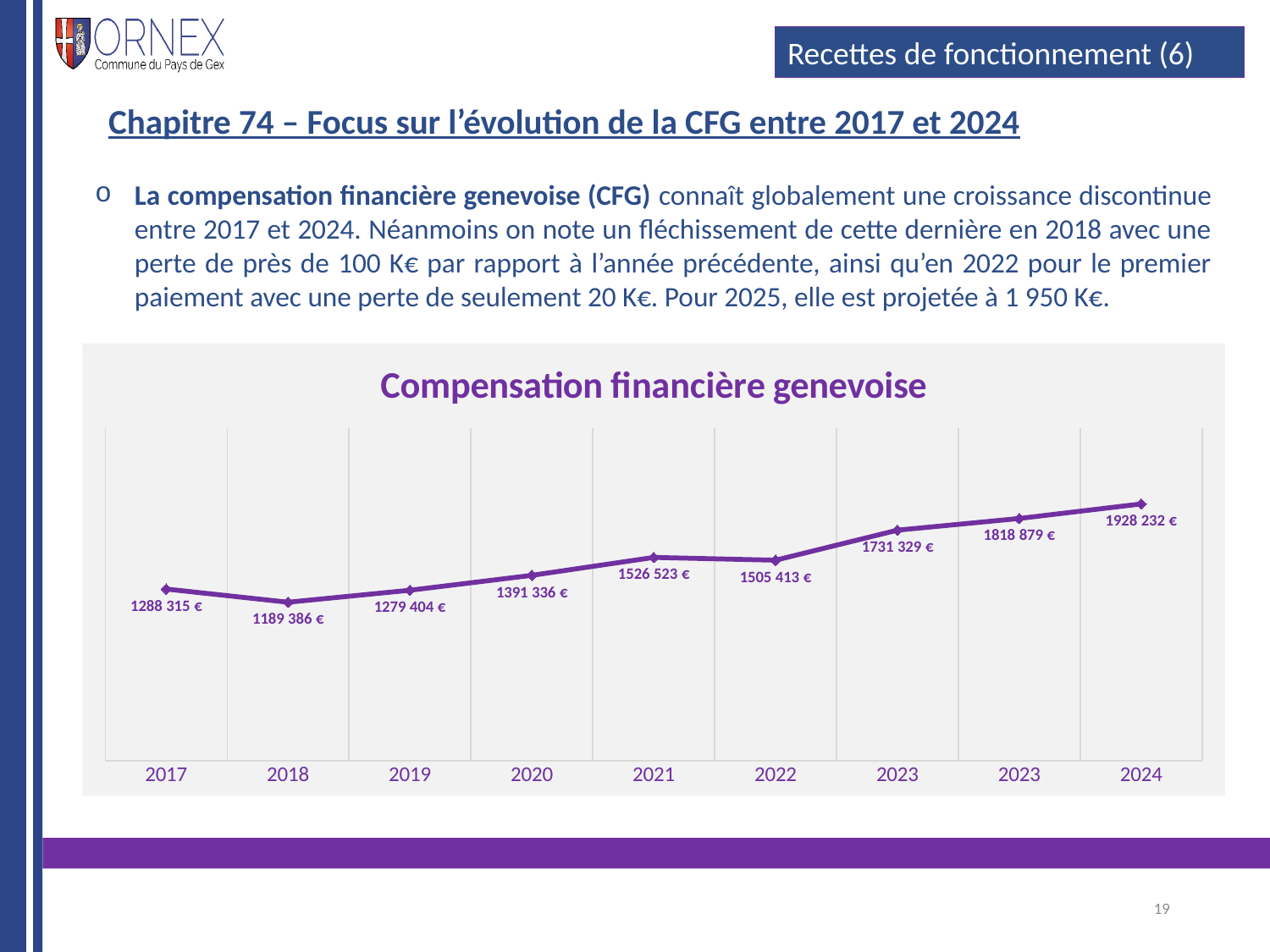
What is the value plotted for 2024? 1928 232 € What kind of chart is shown on the slide? Line chart What is the value plotted for 2018? 1189 386 € What is the difference between the 2021 value and the 2022 value? 21 110 € What is the value plotted for 2020? 1391 336 € How many data points are plotted on the chart? 9 Which year has the lowest value on the chart? 2018 Which is larger, the value for 2021 or the value for 2022? 2021 What is the value plotted for 2017? 1288 315 € What is the title of the chart? Compensation financière genevoise By how much did the value fall from 2017 to 2018? 98 929 € Which year has the highest value on the chart? 2024